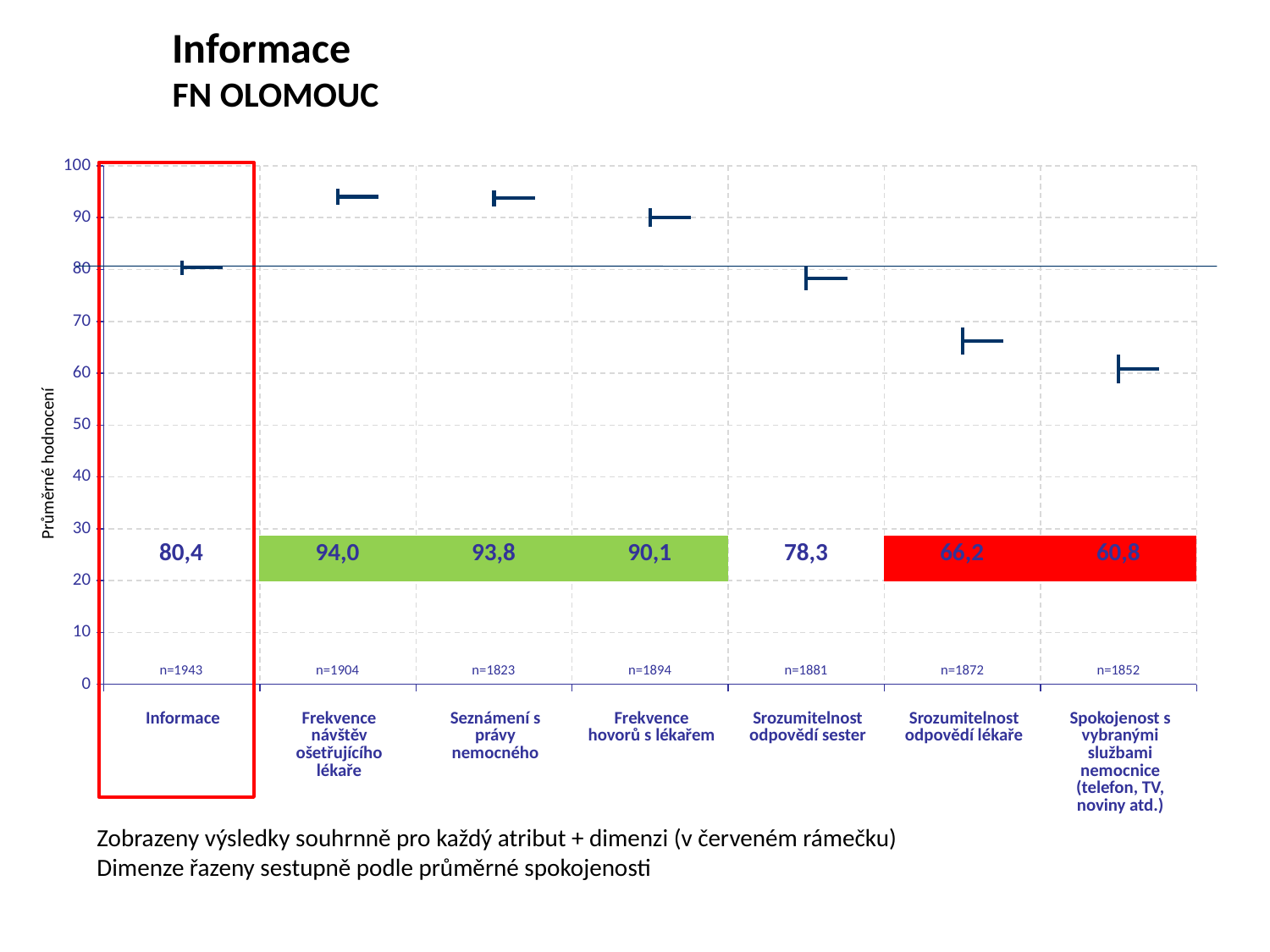
Which attribute has the highest average rating? Frekvence návštěv ošetřujícího lékaře How many categories are shown on the x axis of the chart? 7 What is the average rating (průměrné hodnocení) for 'Informace'? 80,4 What is the value shown for 'Frekvence návštěv ošetřujícího lékaře'? 94,0 What is the label of the y axis of the chart? Průměrné hodnocení What is the difference between the values for 'Frekvence návštěv ošetřujícího lékaře' and 'Srozumitelnost odpovědí lékaře'? 27,8 What is the sample size (n) shown for 'Seznámení s právy nemocného'? n=1823 Which has a higher value: 'Frekvence hovorů s lékařem' or 'Srozumitelnost odpovědí sester'? Frekvence hovorů s lékařem What is the value shown for 'Spokojenost s vybranými službami nemocnice (telefon, TV, noviny atd.)'? 60,8 Which attribute has the lowest average rating? Spokojenost s vybranými službami nemocnice (telefon, TV, noviny atd.) What is the value shown for 'Srozumitelnost odpovědí sester'? 78,3 Is the value for 'Srozumitelnost odpovědí lékaře' greater or less than 70? less